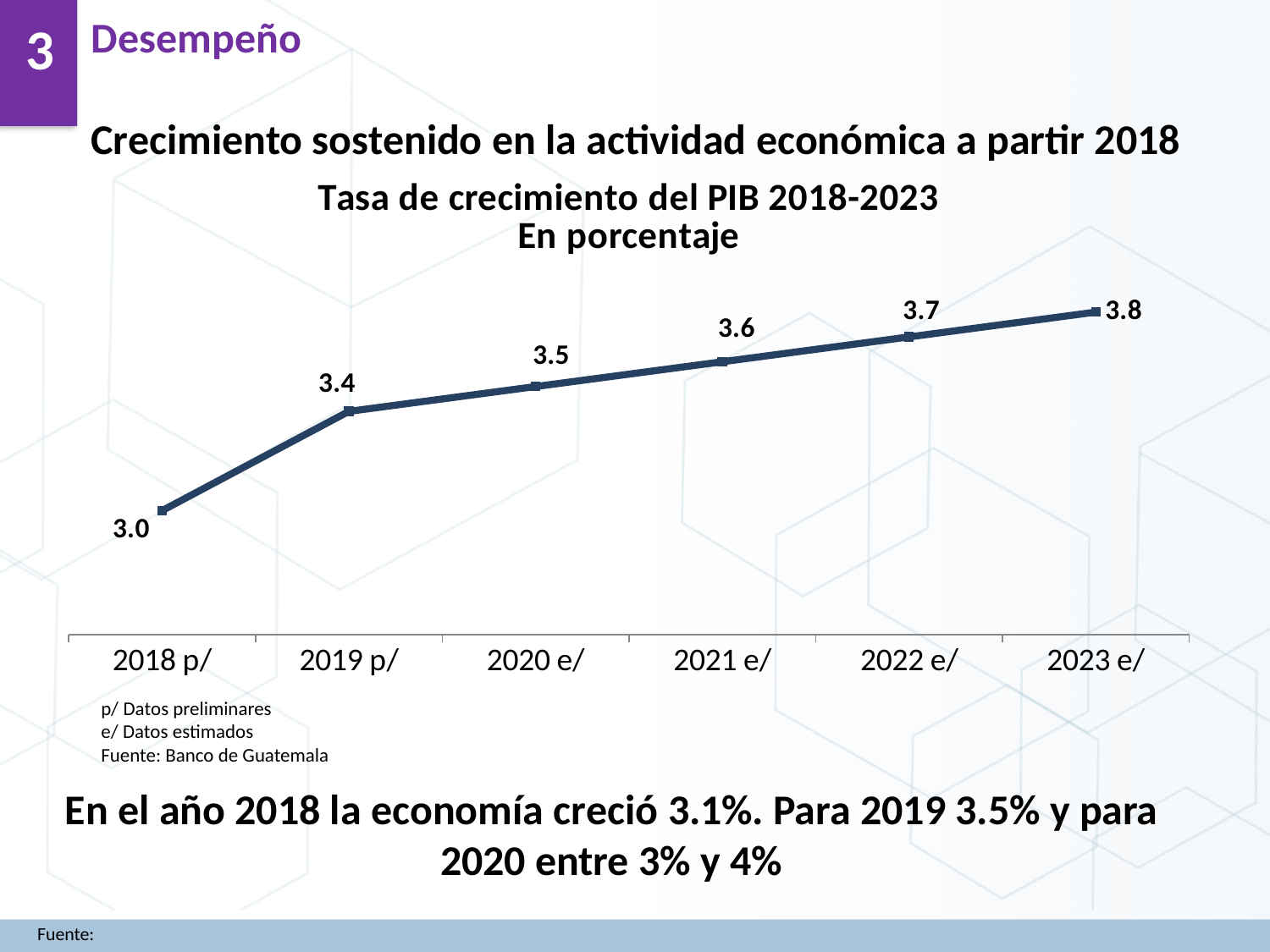
How many data points are plotted on the chart? 6 What kind of chart is shown? Line chart What is the value for 2023 e/? 3.8 What is the value for 2021 e/? 3.6 What is the difference between the values for 2019 p/ and 2018 p/? 0.4 Which year has the highest value? 2023 e/ What is the value for 2019 p/? 3.4 What is the value for 2018 p/? 3.0 What is the difference between the values for 2023 e/ and 2018 p/? 0.8 Which year has the lowest value? 2018 p/ Do the values rise or fall from 2018 p/ to 2023 e/? Rise Which is larger, the value for 2020 e/ or the value for 2022 e/? 2022 e/